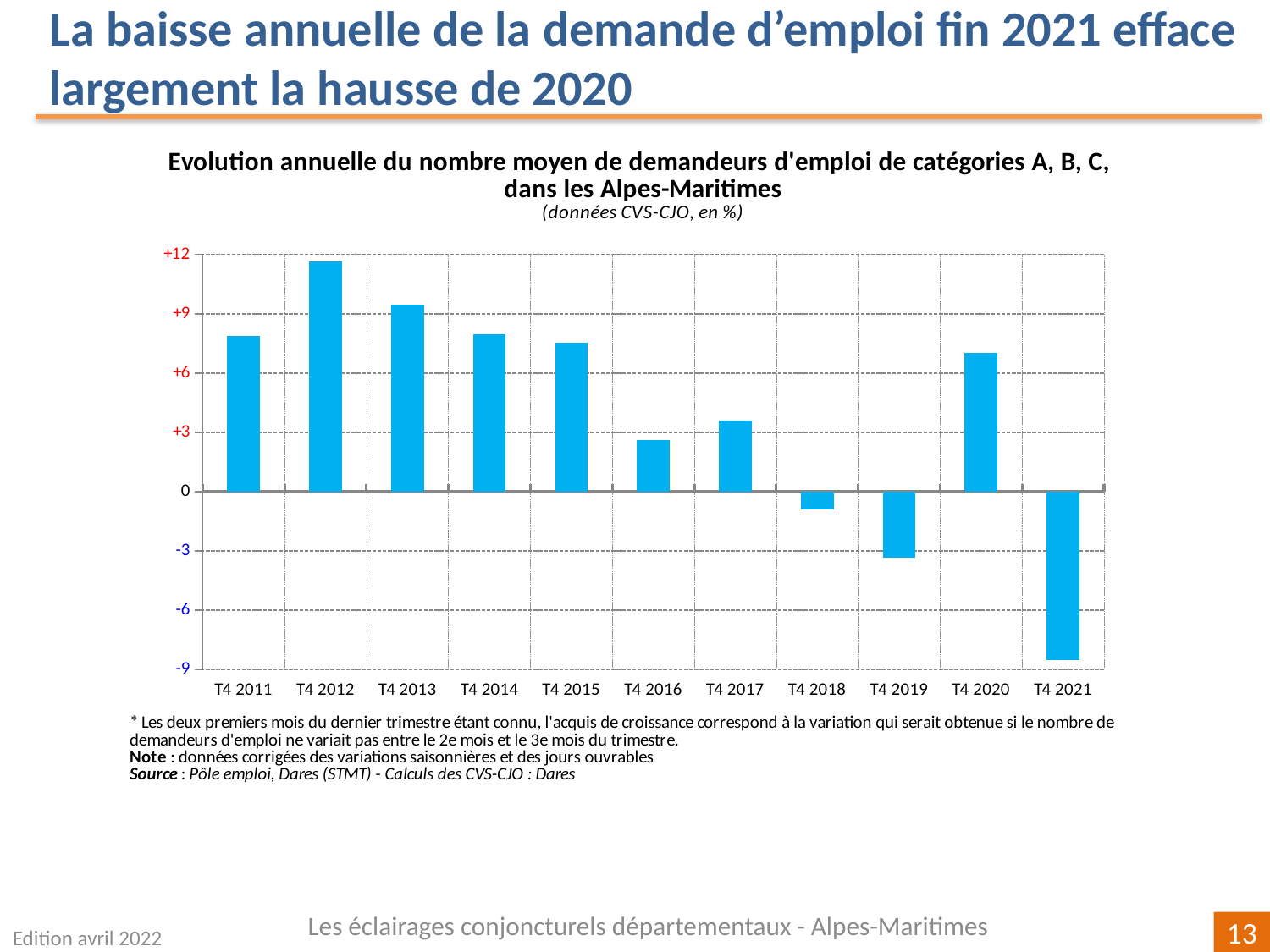
Do the values rise or fall from T4 2012 to T4 2016? fall Is the value for T4 2020 greater or less than +6? greater Is the value for T4 2012 greater or less than +9? greater In which département does the chart measure the evolution of job seekers? Alpes-Maritimes Which quarter has the lowest annual change? T4 2021 Which is larger, the value for T4 2011 or the value for T4 2016? T4 2011 What kind of chart is shown on the slide? bar chart Is the value for T4 2018 greater or less than -3? greater How many quarters (categories) are plotted on the x axis? 11 Which quarter has the highest annual change? T4 2012